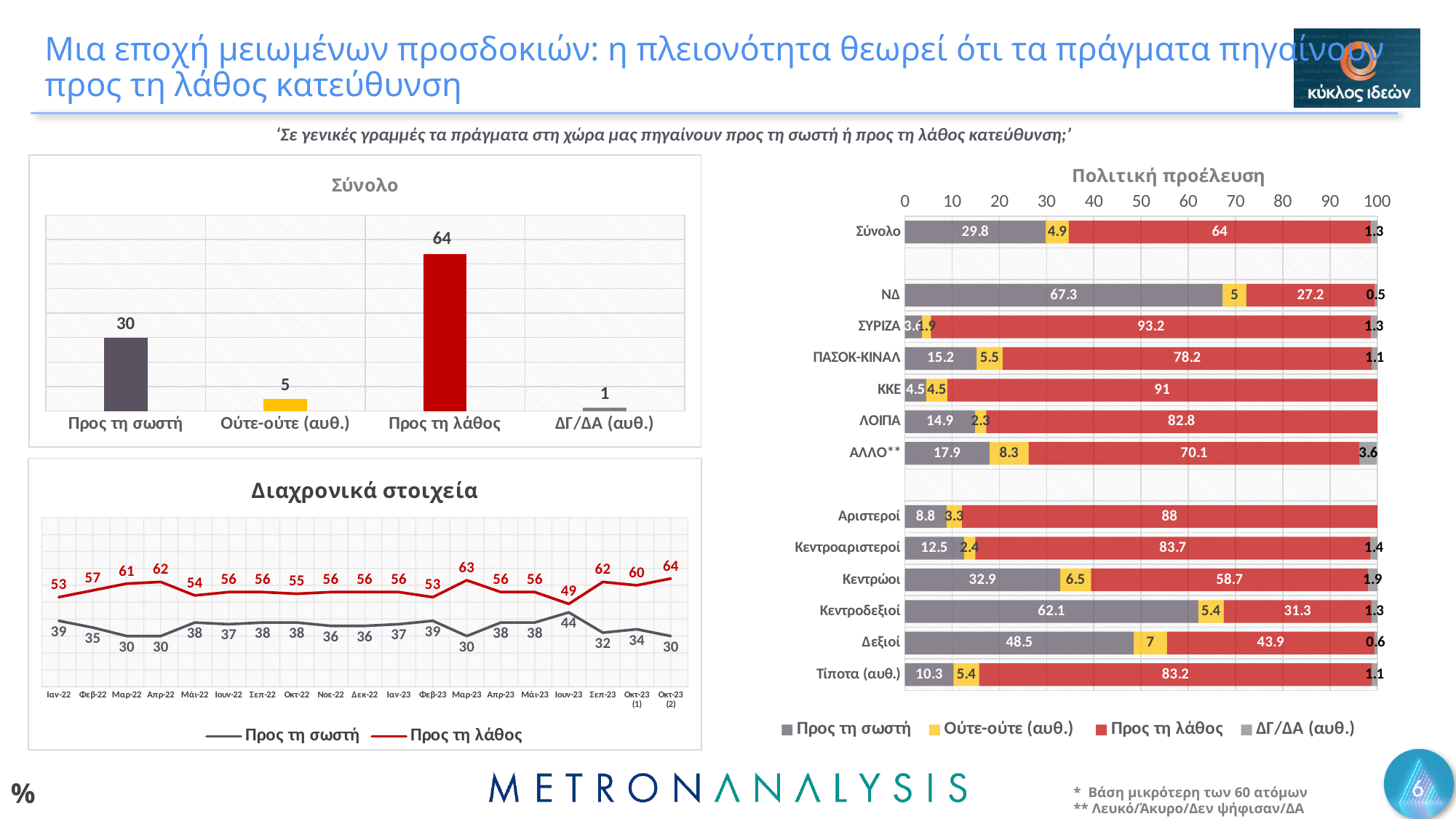
In the 'Διαχρονικά στοιχεία' chart, what is the value of 'Προς τη λάθος' for Ιουν-23? 49 In the 'Διαχρονικά στοιχεία' chart, how many series does the legend list? 2 In the 'Διαχρονικά στοιχεία' chart, what is the value of 'Προς τη σωστή' for Ιαν-22? 39 In the 'Πολιτική προέλευση' chart, which group has the highest 'Προς τη σωστή' value? ΝΔ In the 'Πολιτική προέλευση' chart, what is the 'Ούτε-ούτε (αυθ.)' value for Δεξιοί? 7 In the 'Σύνολο' chart, how many categories are shown? 4 In the 'Πολιτική προέλευση' chart, what is the 'Προς τη λάθος' value for ΣΥΡΙΖΑ? 93.2 In the 'Σύνολο' chart, which category has the lowest value? ΔΓ/ΔΑ (αυθ.) In the 'Σύνολο' chart, what is the value for 'Προς τη λάθος'? 64 In the 'Σύνολο' chart, what is the difference between 'Προς τη λάθος' and 'Προς τη σωστή'? 34 In the 'Πολιτική προέλευση' chart, is the 'Προς τη σωστή' value for Δεξιοί larger than that for Κεντρώοι? Yes What kind of chart is 'Διαχρονικά στοιχεία'? line chart